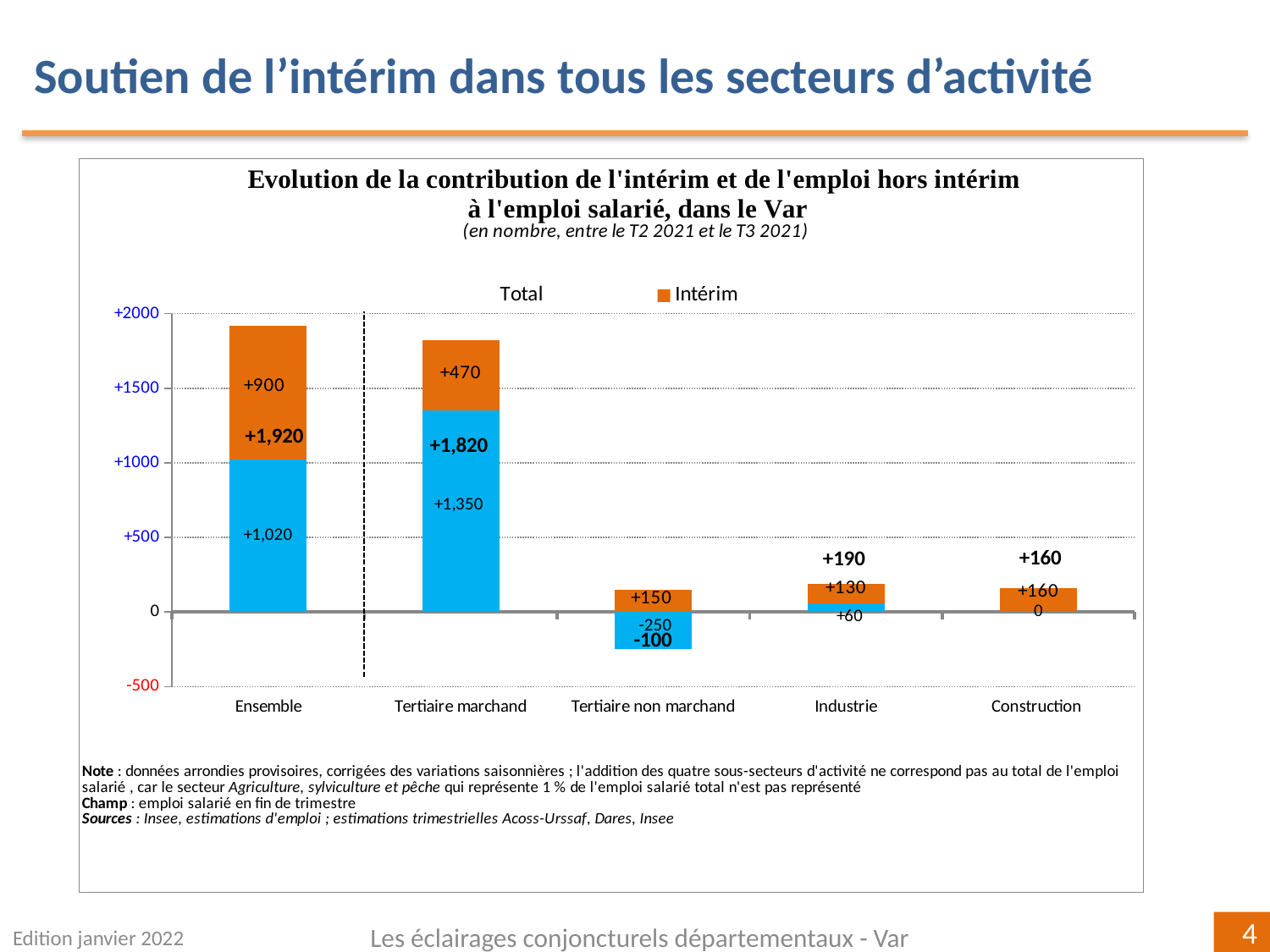
What is the difference between the Intérim value for Ensemble and the Intérim value for Tertiaire marchand? 430 Which has the larger Intérim value, Industrie or Construction? Construction What is the value of the blue segment for Construction? 0 Which category has the lowest total value? Tertiaire non marchand What is the value of the blue segment for Tertiaire non marchand? -250 What kind of chart is this? Stacked bar chart Which category has the highest Intérim value? Ensemble How many categories are shown on the x axis? 5 What colour represents the Intérim series? Orange What is the total value shown for Industrie? +190 What is the Intérim value for Ensemble? +900 What is the Intérim value for Tertiaire marchand? +470